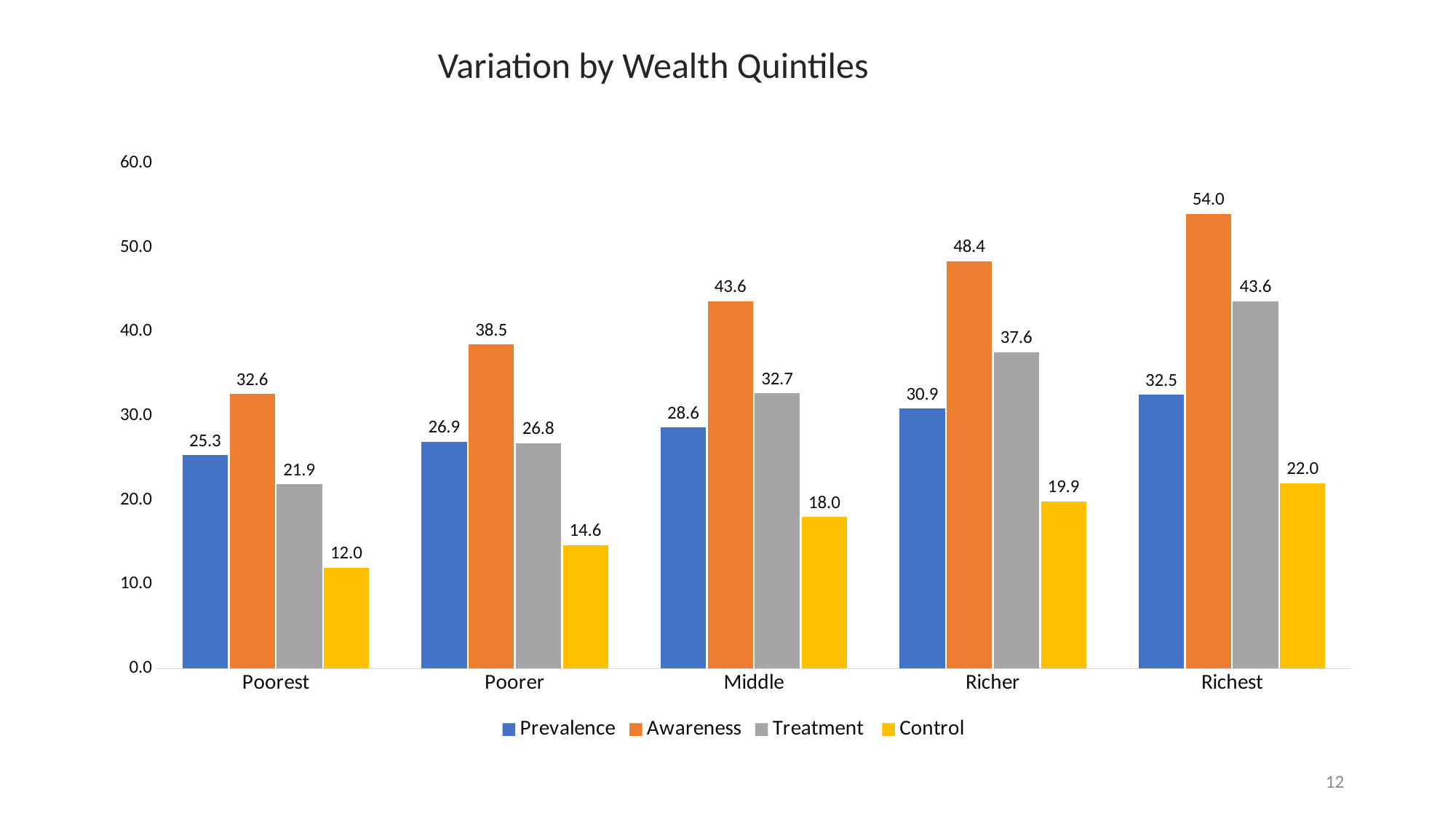
What is the difference between the Awareness and Control values for the Richer quintile? 28.5 Which wealth quintile has the highest Awareness value? Richest Which is larger, the Treatment value for Richest or the Awareness value for Poorer? Treatment value for Richest How many wealth quintile categories are shown on the x axis? 5 What is the Awareness value for the Richest quintile? 54.0 Do the Awareness values rise or fall from Poorest to Richest? Rise Which wealth quintile has the lowest Prevalence value? Poorest What is the Treatment value for the Middle quintile? 32.7 How many series does the legend list? 4 Is the Treatment value for the Richer quintile greater or less than 40.0? less What is the Control value for the Poorest quintile? 12.0 What kind of chart is shown on the slide? Bar chart